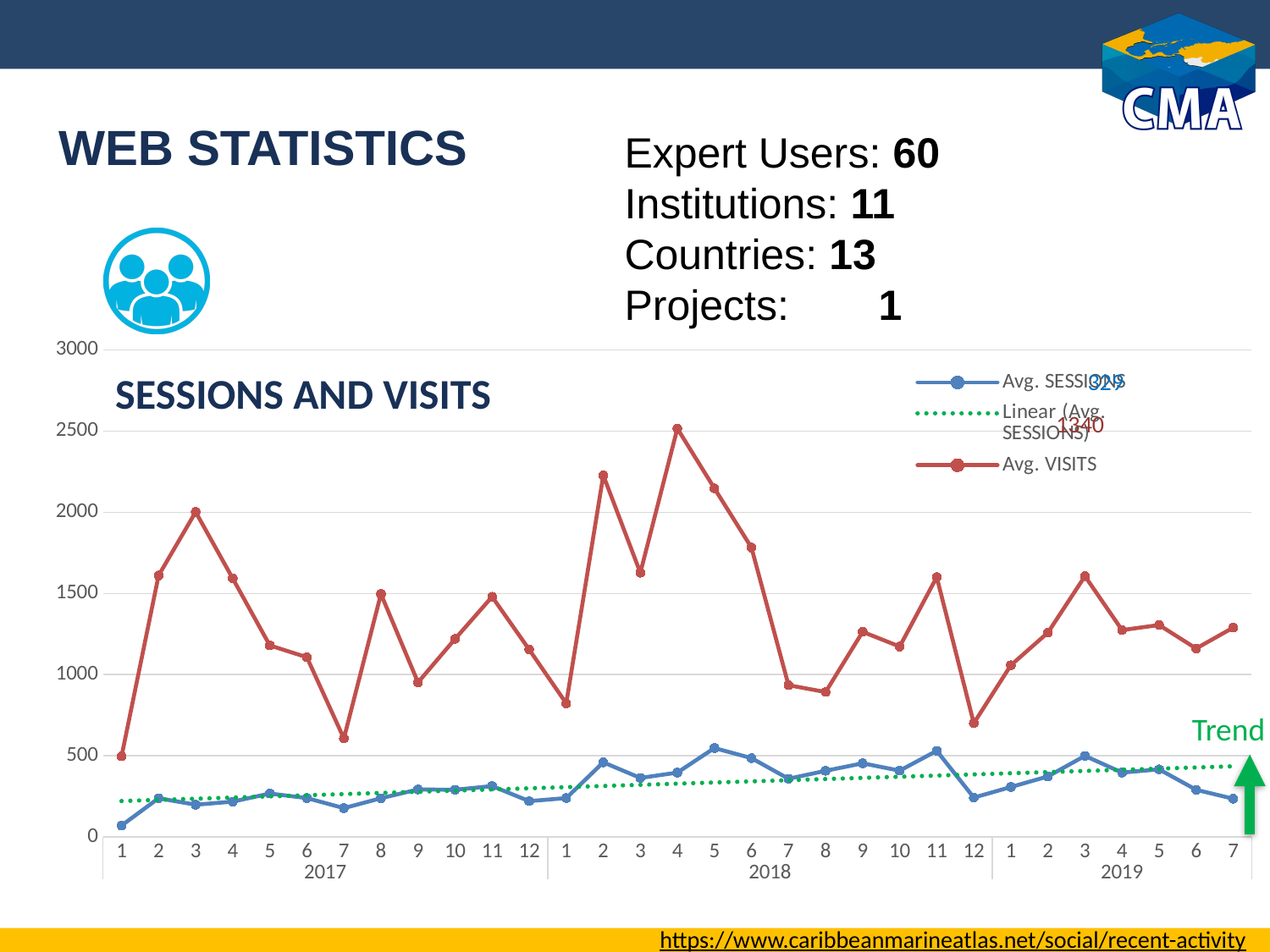
In which month and year does Avg. VISITS reach its highest value? Month 4 of 2018 In which month and year is Avg. SESSIONS at its lowest? Month 1 of 2017 Is the Avg. VISITS value for month 12 of 2018 greater or less than 1000? less Which is larger for Avg. VISITS: month 2 of 2018 or month 3 of 2018? Month 2 of 2018 Is the Avg. VISITS value for month 2 of 2018 greater or less than 2000? greater What colour is the Avg. VISITS line in the chart? red In which month and year is Avg. VISITS at its lowest? Month 1 of 2017 What kind of chart is shown on the slide? line chart What is the title of the chart? SESSIONS AND VISITS Does the Linear (Avg. SESSIONS) trend line rise or fall from left to right? rise How many monthly data points are plotted along the x axis of the chart? 31 How many series does the chart legend list? 3